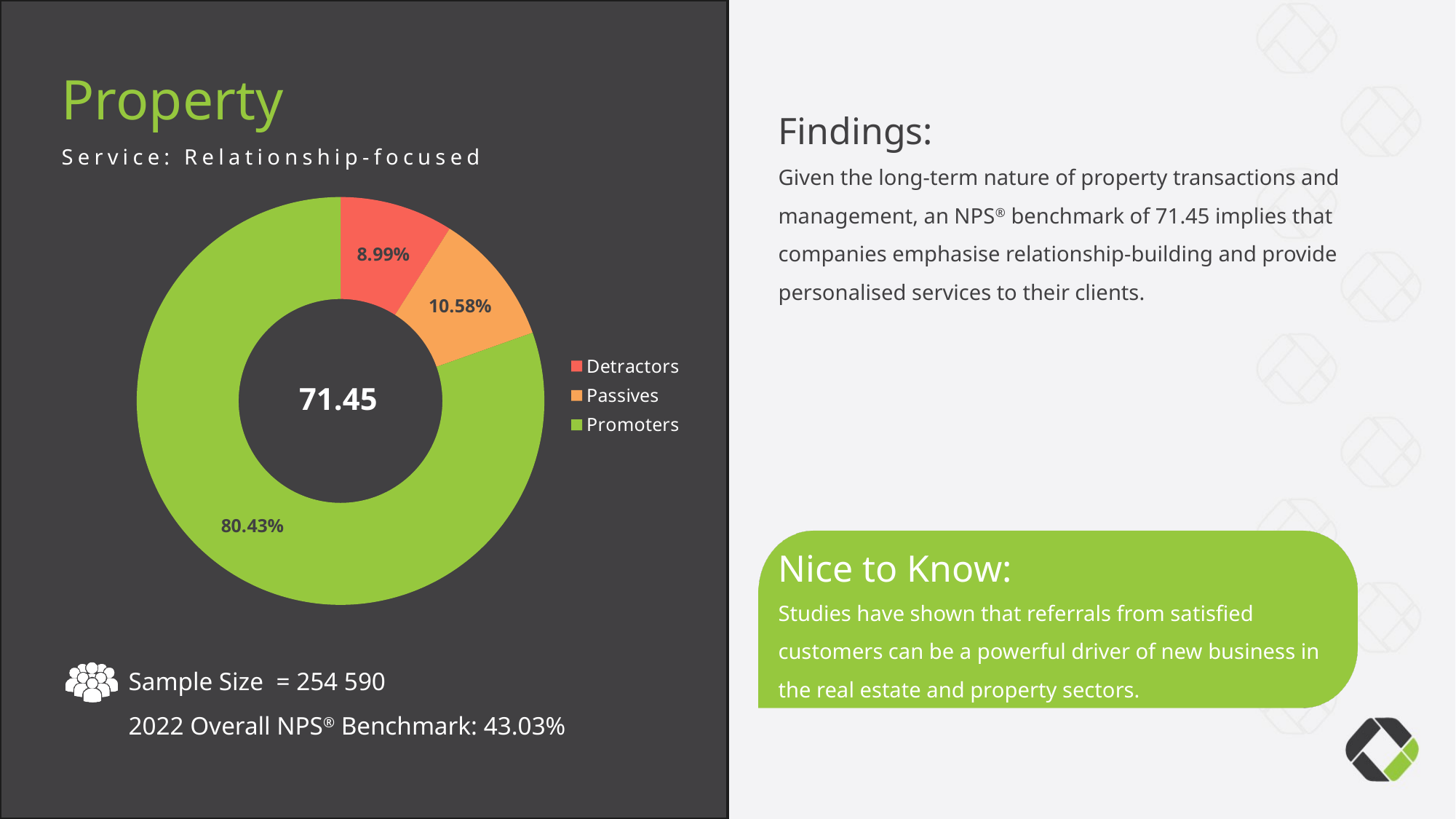
What percentage of the donut chart is Detractors? 8.99% How many categories does the donut chart show? 3 What percentage of the donut chart is Promoters? 80.43% Which category has the smallest share of the donut chart? Detractors What is the difference in percentage points between Promoters and Passives? 69.85 What kind of chart is shown on the slide? Donut (pie) chart What colour represents Promoters in the donut chart? Green Which is larger, the Passives share or the Detractors share? Passives What number is displayed in the centre of the donut chart? 71.45 What percentage of the donut chart is Passives? 10.58% Which category has the largest share of the donut chart? Promoters What is the difference in percentage points between Passives and Detractors? 1.59